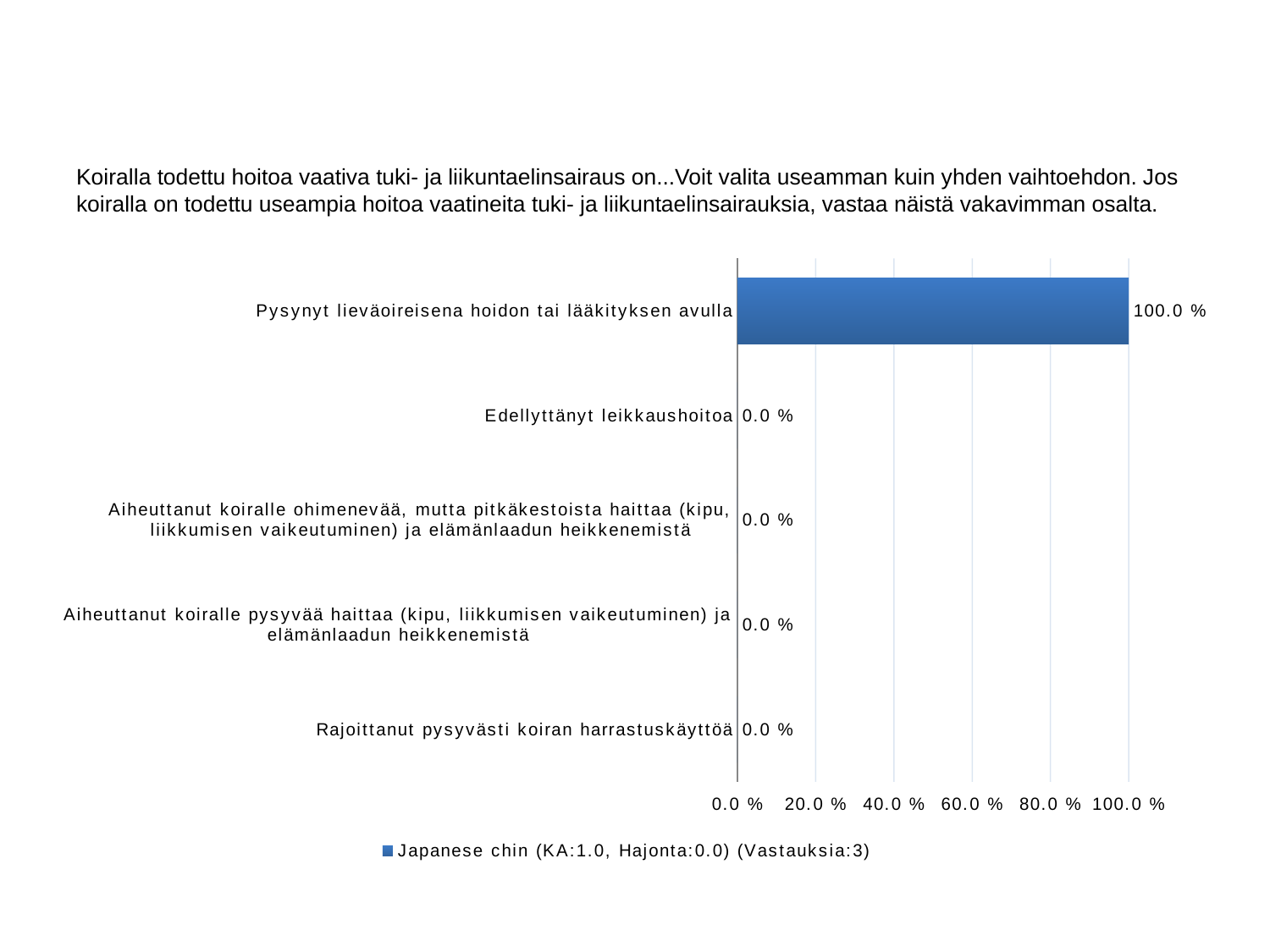
Is the value for "Pysynyt lieväoireisena hoidon tai lääkityksen avulla" greater or less than 80.0 %? greater How many categories have a value of 0.0 %? 4 What is the series name shown in the legend? Japanese chin (KA:1.0, Hajonta:0.0) (Vastauksia:3) Which category has the highest value? Pysynyt lieväoireisena hoidon tai lääkityksen avulla What is the difference between the values for "Pysynyt lieväoireisena hoidon tai lääkityksen avulla" and "Edellyttänyt leikkaushoitoa"? 100.0 % What is the value for "Rajoittanut pysyvästi koiran harrastuskäyttöä"? 0.0 % How many categories are shown in the chart? 5 What is the value for "Edellyttänyt leikkaushoitoa"? 0.0 % What is the value for "Pysynyt lieväoireisena hoidon tai lääkityksen avulla"? 100.0 % How many series does the legend list? 1 What kind of chart is shown on the slide? bar chart Which is larger: the value for "Pysynyt lieväoireisena hoidon tai lääkityksen avulla" or the value for "Rajoittanut pysyvästi koiran harrastuskäyttöä"? Pysynyt lieväoireisena hoidon tai lääkityksen avulla